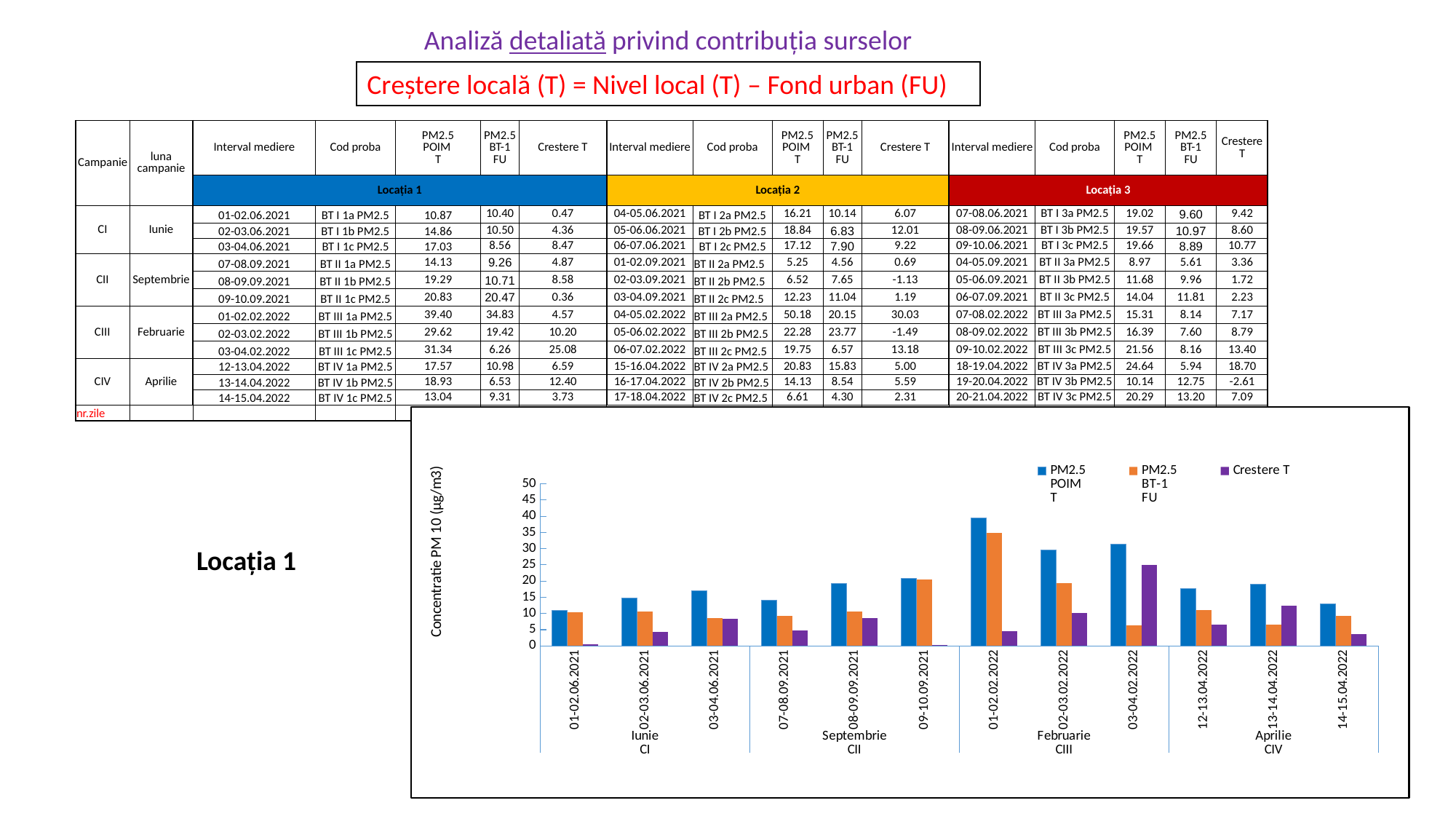
Which date interval has the lowest PM2.5 POIM T bar in the chart? 01-02.06.2021 For 02-03.02.2022, which is larger: PM2.5 POIM T or PM2.5 BT-1 FU? PM2.5 POIM T Is the PM2.5 BT-1 FU value for 03-04.02.2022 greater or less than 10? less Is the PM2.5 POIM T value for 01-02.02.2022 greater or less than 35? greater How many date intervals (categories) are plotted along the x axis of the chart? 12 Is the Crestere T value for 03-04.02.2022 greater or less than 20? greater How many series does the chart legend list? 3 Which date interval has the highest PM2.5 POIM T bar in the chart? 01-02.02.2022 What is the label of the chart's vertical axis? Concentratie PM 10 (µg/m3) For 13-14.04.2022, which is larger: Crestere T or PM2.5 BT-1 FU? Crestere T What kind of chart is shown on the slide? bar chart Which date interval has the highest Crestere T bar in the chart? 03-04.02.2022